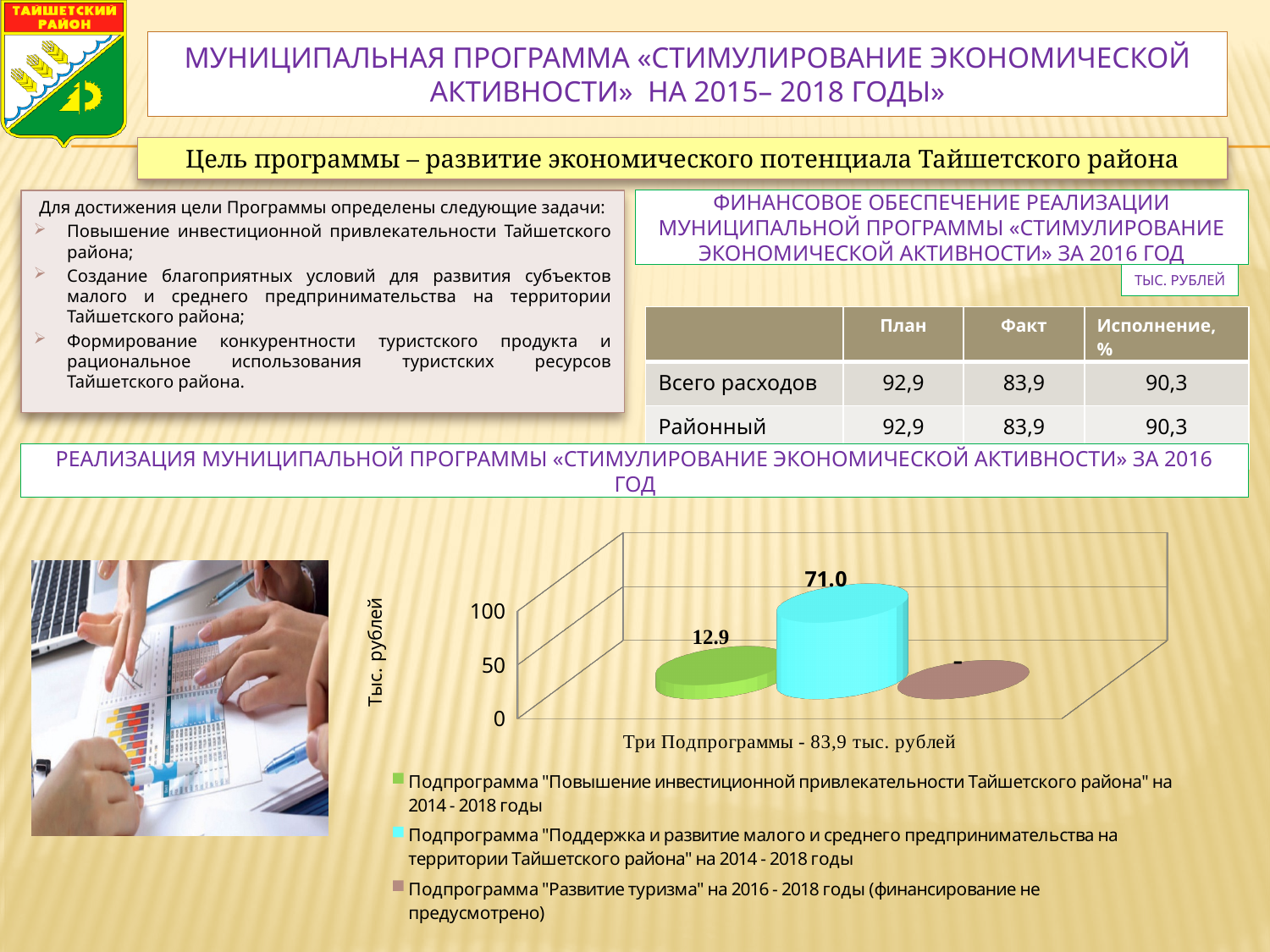
What is the value shown for the subprogram "Поддержка и развитие малого и среднего предпринимательства на территории Тайшетского района" на 2014 - 2018 годы? 71.0 What is the difference between the values 71.0 and 12.9 shown in the chart? 58.1 What unit is shown on the vertical axis of the chart? Тыс. рублей Which is larger: the value for the investment attractiveness subprogram or the value for the small and medium business support subprogram? The small and medium business support subprogram (71.0) Is the value for the investment attractiveness subprogram greater or less than 50? less What is the category label shown below the bars in the chart? Три Подпрограммы - 83,9 тыс. рублей What kind of chart is shown on the slide? Bar chart (3D cylinder bars) Is the value for the small and medium business support subprogram greater or less than 50? greater Which subprogram has the highest value in the chart? Подпрограмма "Поддержка и развитие малого и среднего предпринимательства на территории Тайшетского района" на 2014 - 2018 годы What label is shown for the tourism development subprogram's bar in the chart? - What is the value shown for the subprogram "Повышение инвестиционной привлекательности Тайшетского района" на 2014 - 2018 годы? 12.9 How many series does the chart legend list? 3